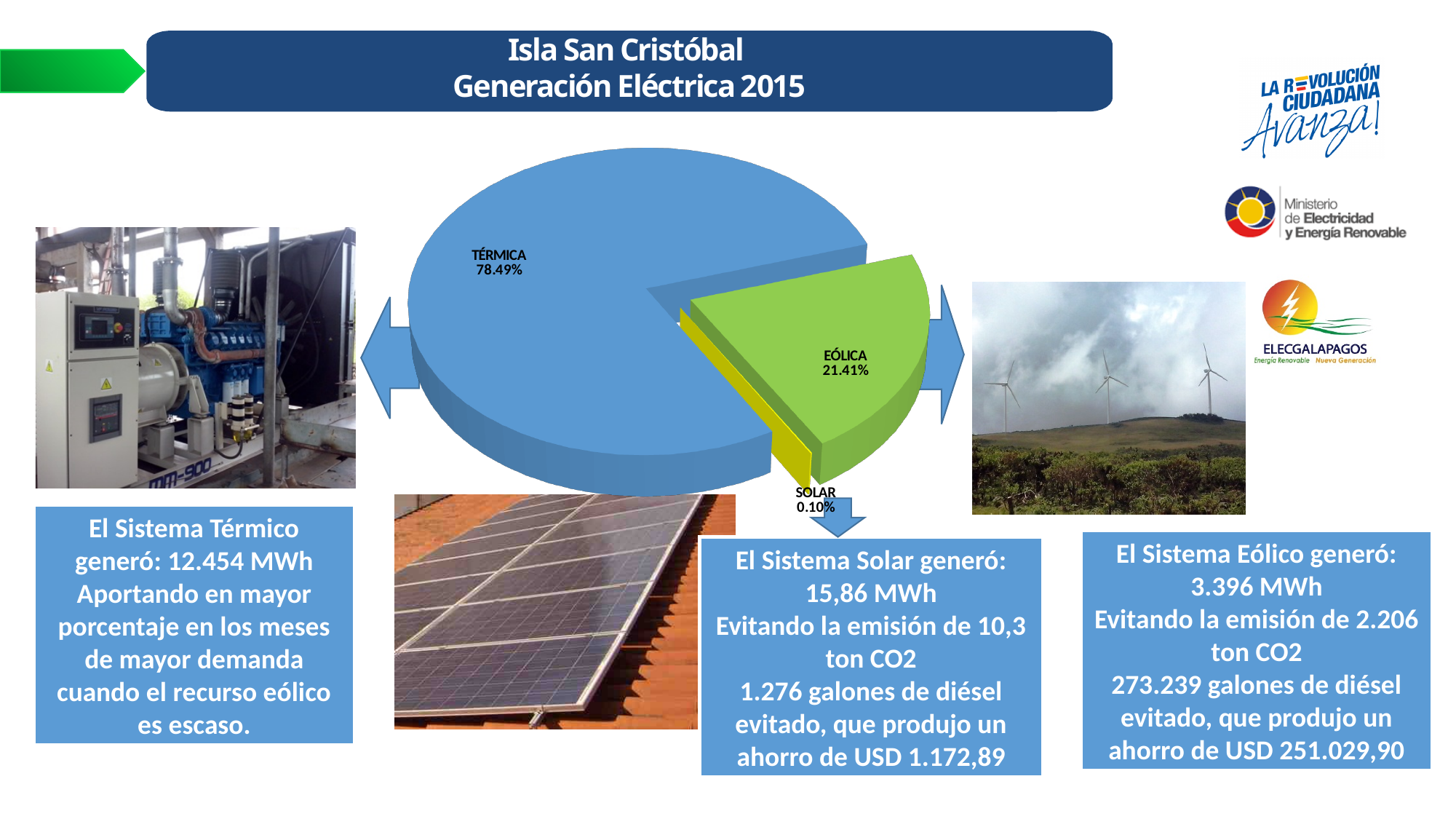
What is the difference in percentage points between the TÉRMICA and EÓLICA slices? 57.08% What kind of chart is shown on the slide? pie chart What share of the pie does EÓLICA represent? 21.41% How many slices does the pie chart have? 3 Which slice of the pie chart is the largest? TÉRMICA What is the difference in percentage points between the EÓLICA and SOLAR slices? 21.31% Which slice of the pie chart is the smallest? SOLAR What colour is the EÓLICA slice in the pie chart? green What share of the pie does TÉRMICA represent? 78.49% What share of the pie does SOLAR represent? 0.10% Is the share for TÉRMICA greater or less than 50%? greater Which is larger in the pie chart, EÓLICA or SOLAR? EÓLICA